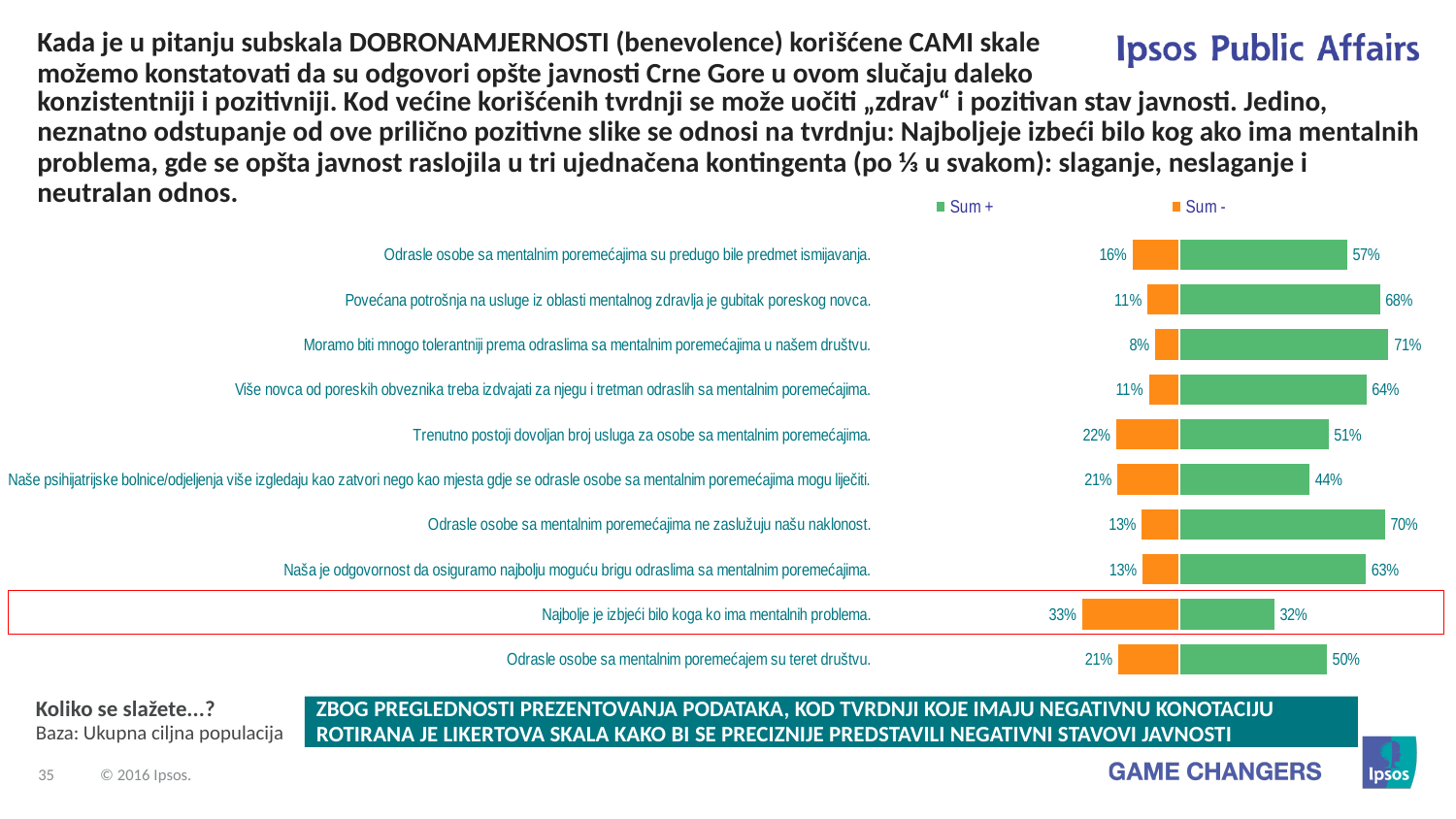
What is the Sum + value for "Odrasle osobe sa mentalnim poremećajem su teret društvu"? 50% Which statement has the highest Sum + value? Moramo biti mnogo tolerantniji prema odraslima sa mentalnim poremećajima u našem društvu What type of chart is shown on the slide? bar chart How many series does the chart legend list? 2 Which colour represents the Sum + series in the chart? green What is the Sum + value for "Moramo biti mnogo tolerantniji prema odraslima sa mentalnim poremećajima u našem društvu"? 71% Which is larger: the Sum + value for "Trenutno postoji dovoljan broj usluga za osobe sa mentalnim poremećajima" or the Sum + value for "Naša je odgovornost da osiguramo najbolju moguću brigu odraslima sa mentalnim poremećajima"? Naša je odgovornost da osiguramo najbolju moguću brigu odraslima sa mentalnim poremećajima Which statement has the lowest Sum - value? Moramo biti mnogo tolerantniji prema odraslima sa mentalnim poremećajima u našem društvu What is the difference between the Sum + and Sum - values for "Odrasle osobe sa mentalnim poremećajima su predugo bile predmet ismijavanja"? 41% What is the Sum - value for "Najbolje je izbjeći bilo koga ko ima mentalnih problema"? 33% How many statements (categories) are plotted in the chart? 10 Which statement has the lowest Sum + value? Najbolje je izbjeći bilo koga ko ima mentalnih problema